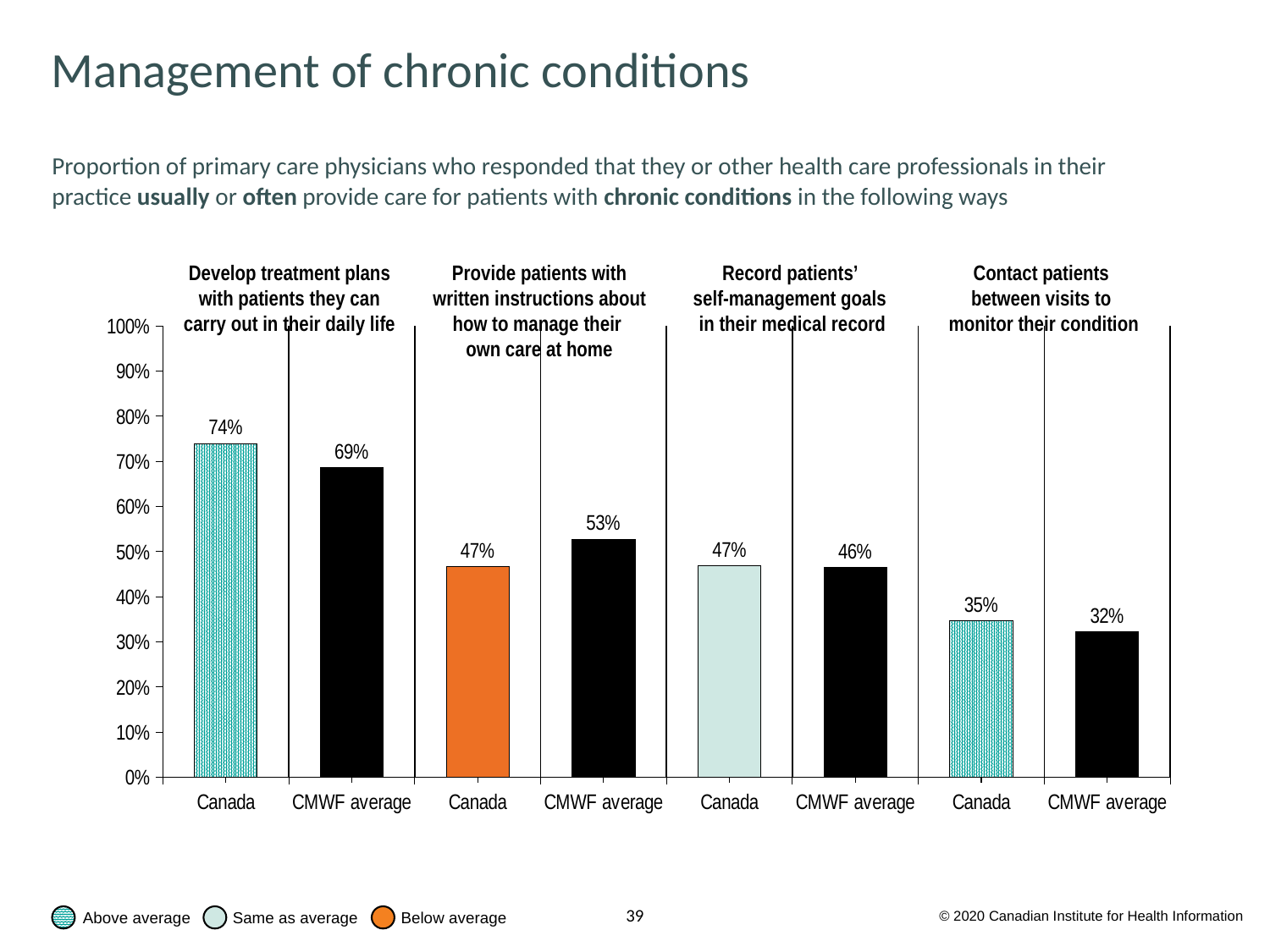
Which bar has the lowest value on the chart? CMWF average, Contact patients between visits to monitor their condition (32%) For "Provide patients with written instructions about how to manage their own care at home", which is larger: Canada or the CMWF average? CMWF average What is the CMWF average for "Provide patients with written instructions about how to manage their own care at home"? 53% What is the CMWF average for "Record patients' self-management goals in their medical record"? 46% What type of chart is shown on the slide? Bar chart Which bar has the highest value on the chart? Canada, Develop treatment plans with patients they can carry out in their daily life (74%) What is the difference between the CMWF average and Canada for "Provide patients with written instructions about how to manage their own care at home"? 6% According to the legend, what does the orange bar colour indicate? Below average What is the difference between Canada and the CMWF average for "Develop treatment plans with patients they can carry out in their daily life"? 5% What is the value for Canada under "Develop treatment plans with patients they can carry out in their daily life"? 74% What is the value for Canada under "Contact patients between visits to monitor their condition"? 35% How many bars are plotted on the chart? 8